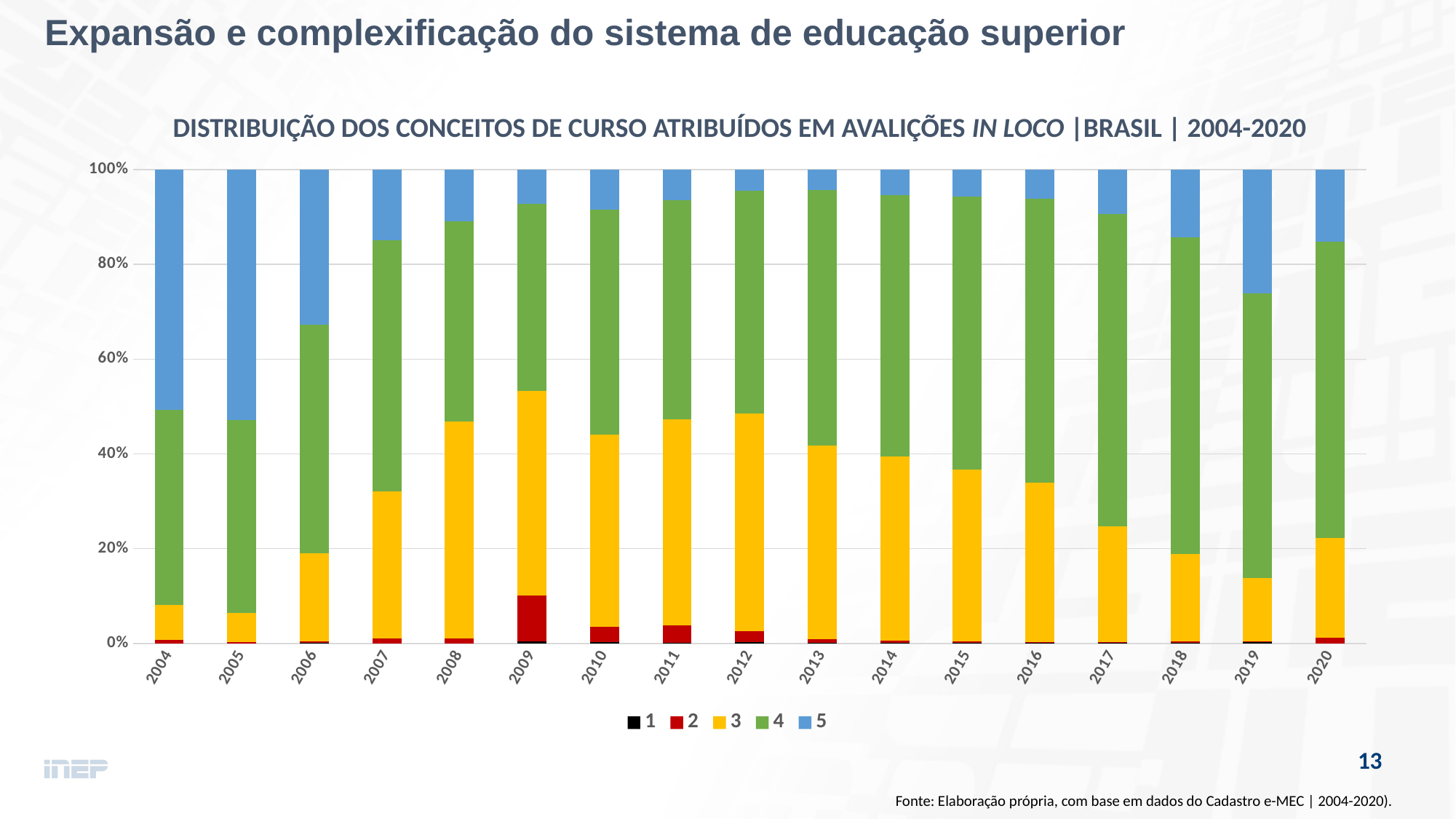
Is the yellow segment (series 3) larger in 2009 or in 2019? 2009 What are the legend entries of the chart? 1, 2, 3, 4, 5 In which year is the red segment (series 2) clearly the largest? 2009 How many series does the chart's legend list? 5 What kind of chart is shown on the slide? Stacked bar chart Does the share of the blue segment (series 5) rise or fall from 2004 to 2009? Fall Is the blue segment (series 5) larger in 2004 or in 2014? 2004 How many years are shown along the x axis of the chart? 17 Which colour represents series 5 in the chart? Blue In 2017, is the top of the green segment (series 4) greater or less than 80%? greater In 2006, is the top of the green segment (series 4) greater or less than 80%? less In 2009, is the top of the yellow segment (series 3) greater or less than 40%? greater